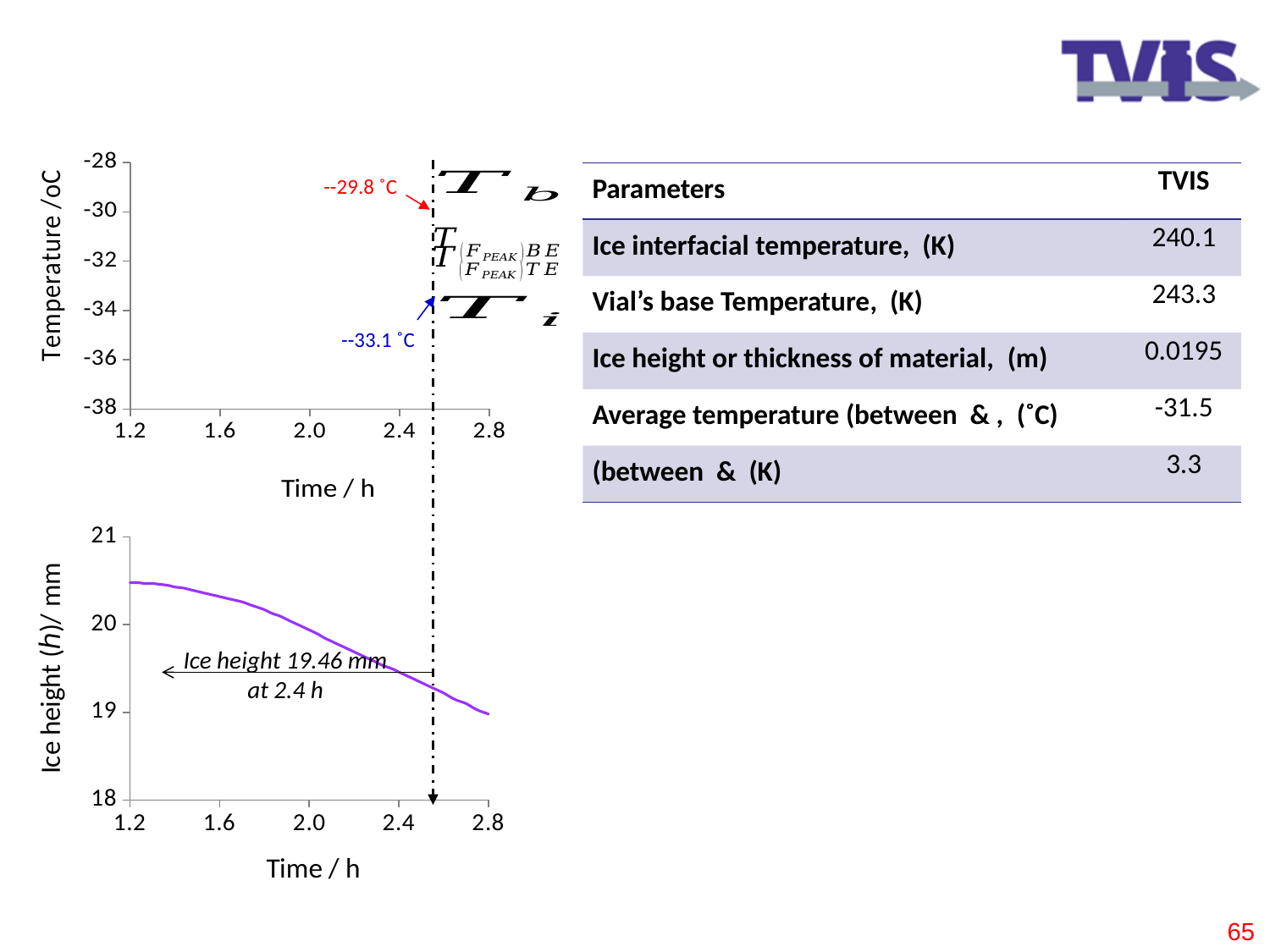
What kind of chart is the bottom chart (Ice height vs Time)? line chart In the top chart (Temperature vs Time), which annotated temperature is higher, -29.8 °C or -33.1 °C? -29.8 °C In the bottom chart (Ice height vs Time), is the ice height at 2.8 h greater or less than 20 mm? less How many tick labels are shown on the x axis of the bottom chart (Ice height vs Time)? 5 In the top chart (Temperature vs Time), what is the difference between the two annotated temperatures, -29.8 °C and -33.1 °C? 3.3 °C In the bottom chart (Ice height vs Time), is the ice height at 1.6 h greater or less than 20 mm? greater What is the x-axis label of the top chart? Time / h In the bottom chart (Ice height vs Time), what ice height is annotated at 2.4 h? 19.46 mm In the bottom chart (Ice height vs Time), is the ice height at 1.2 h greater or less than 20 mm? greater What is the y-axis label of the bottom chart? Ice height (h)/ mm In the bottom chart (Ice height vs Time), does the ice height rise or fall as time increases? fall